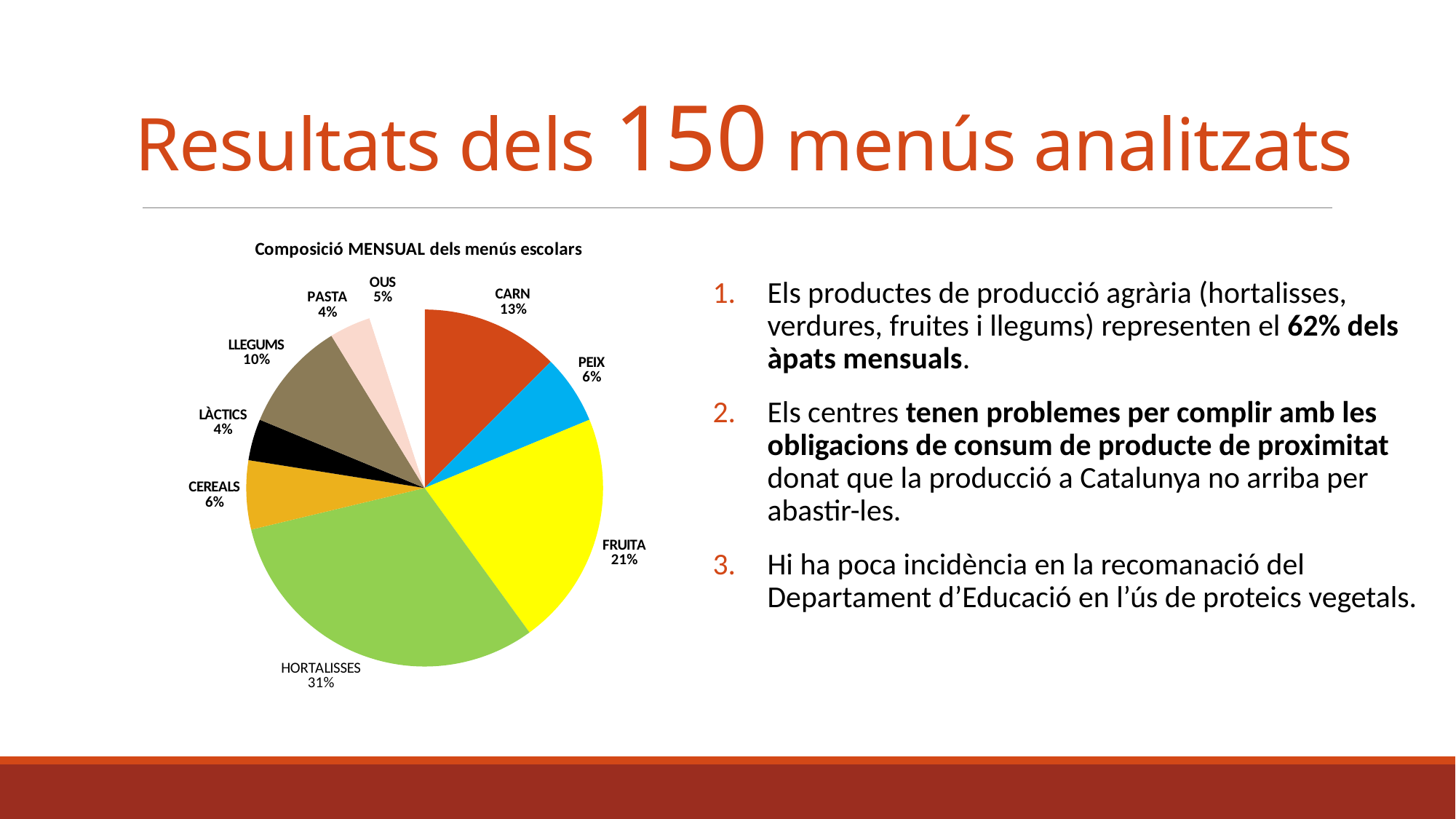
What is the value shown for FRUITA? 21% What is the difference between the HORTALISSES and FRUITA percentages? 10% Which is larger, the slice for CARN or the slice for PEIX? CARN What is the title of the chart? Composició MENSUAL dels menús escolars What colour is the HORTALISSES slice? Green Which category has the largest slice of the pie? HORTALISSES How many categories are shown in the pie chart? 9 What type of chart is shown on the slide? Pie chart What is the value shown for LLEGUMS? 10% What is the value shown for CARN? 13% What is the value shown for OUS? 5% What percentage of the pie does HORTALISSES represent? 31%